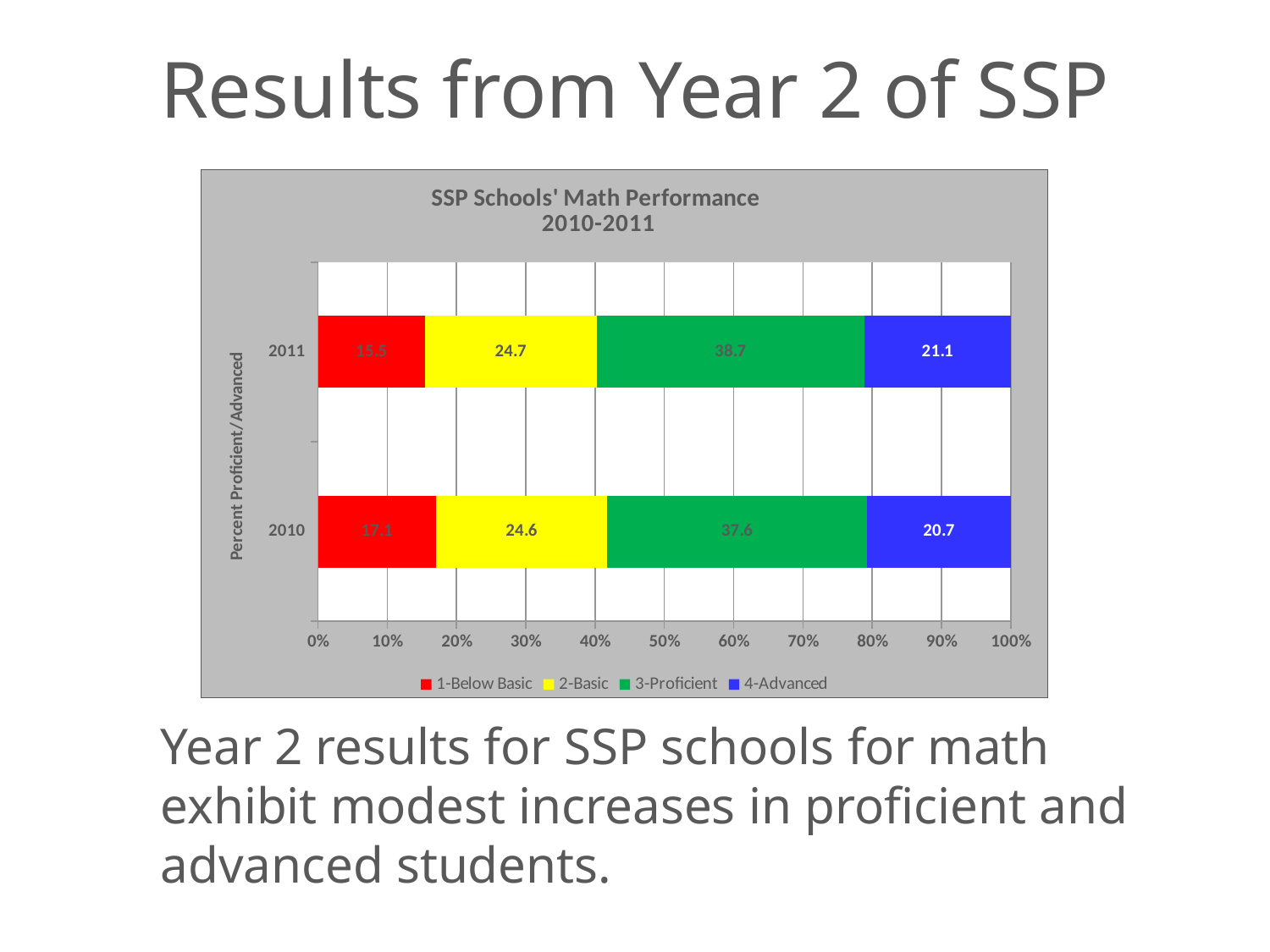
What is the value for 4-Advanced in 2011? 21.1 What is the value for 1-Below Basic in 2010? 17.1 How many series does the legend list? 4 What kind of chart is shown on the slide? Stacked bar chart Which series has the largest segment in the 2010 bar? 3-Proficient Which series has the smallest segment in the 2011 bar? 1-Below Basic What is the value for 2-Basic in 2010? 24.6 Which year has the larger 1-Below Basic value, 2010 or 2011? 2010 What is the value for 3-Proficient in 2011? 38.7 What is the title of the chart? SSP Schools' Math Performance 2010-2011 How many years (categories) are shown in the chart? 2 What is the difference between the 3-Proficient values for 2011 and 2010? 1.1